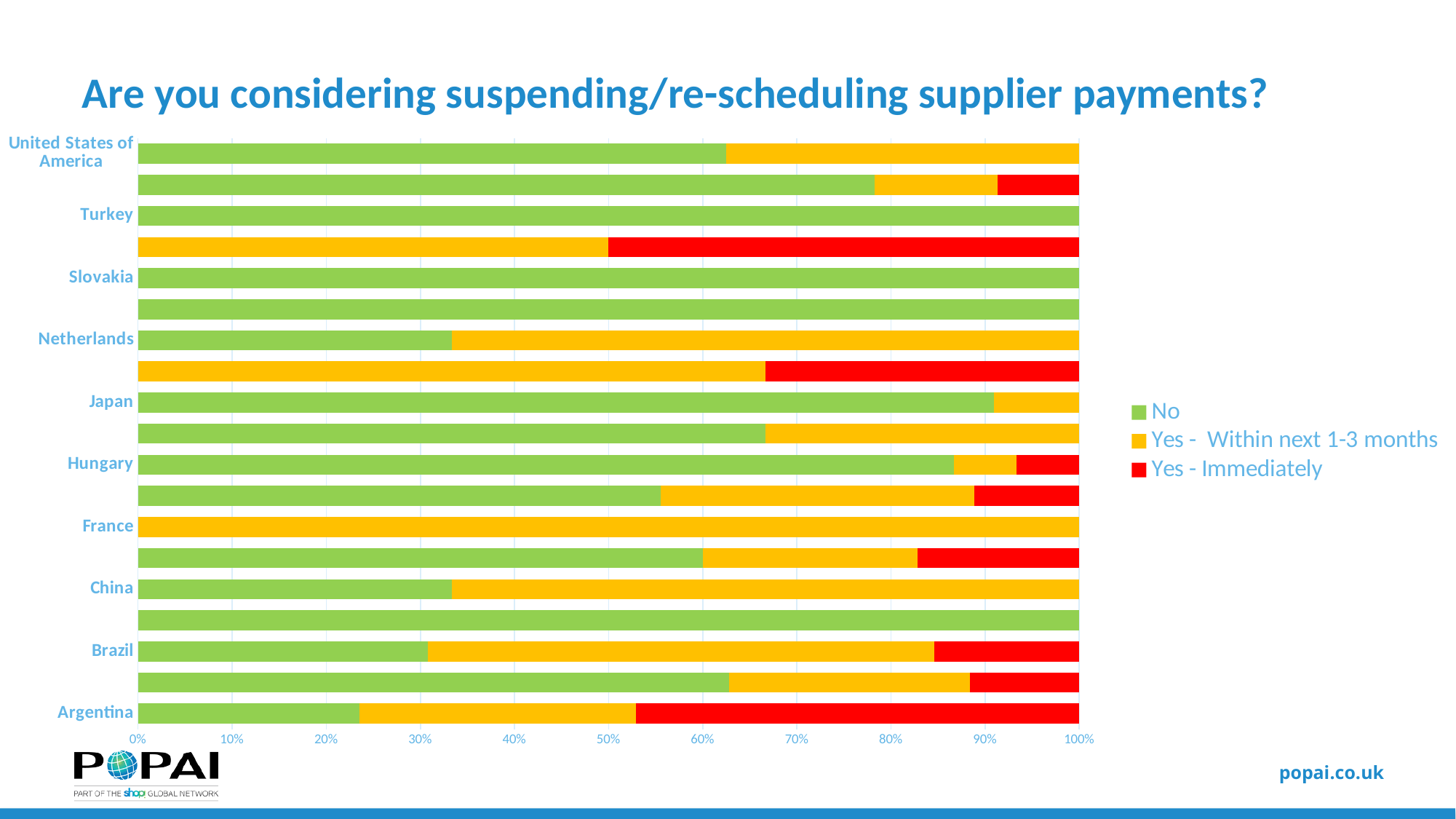
Is the "No" share for the United States of America greater or less than 50%? greater Is the "No" share for Argentina greater or less than 30%? less Is the "No" share for the Netherlands greater or less than 40%? less How many series does the legend list? 3 What share of respondents in France answered "Yes - Within next 1-3 months"? 100% What are the three legend entries in the chart? No; Yes - Within next 1-3 months; Yes - Immediately Which has the larger "No" share, Japan or the Netherlands? Japan Which has the larger "Yes - Immediately" share, Argentina or Brazil? Argentina What is the title of the chart? Are you considering suspending/re-scheduling supplier payments? What kind of chart is shown on the slide? Stacked bar chart What share of respondents in Turkey answered "No"? 100%